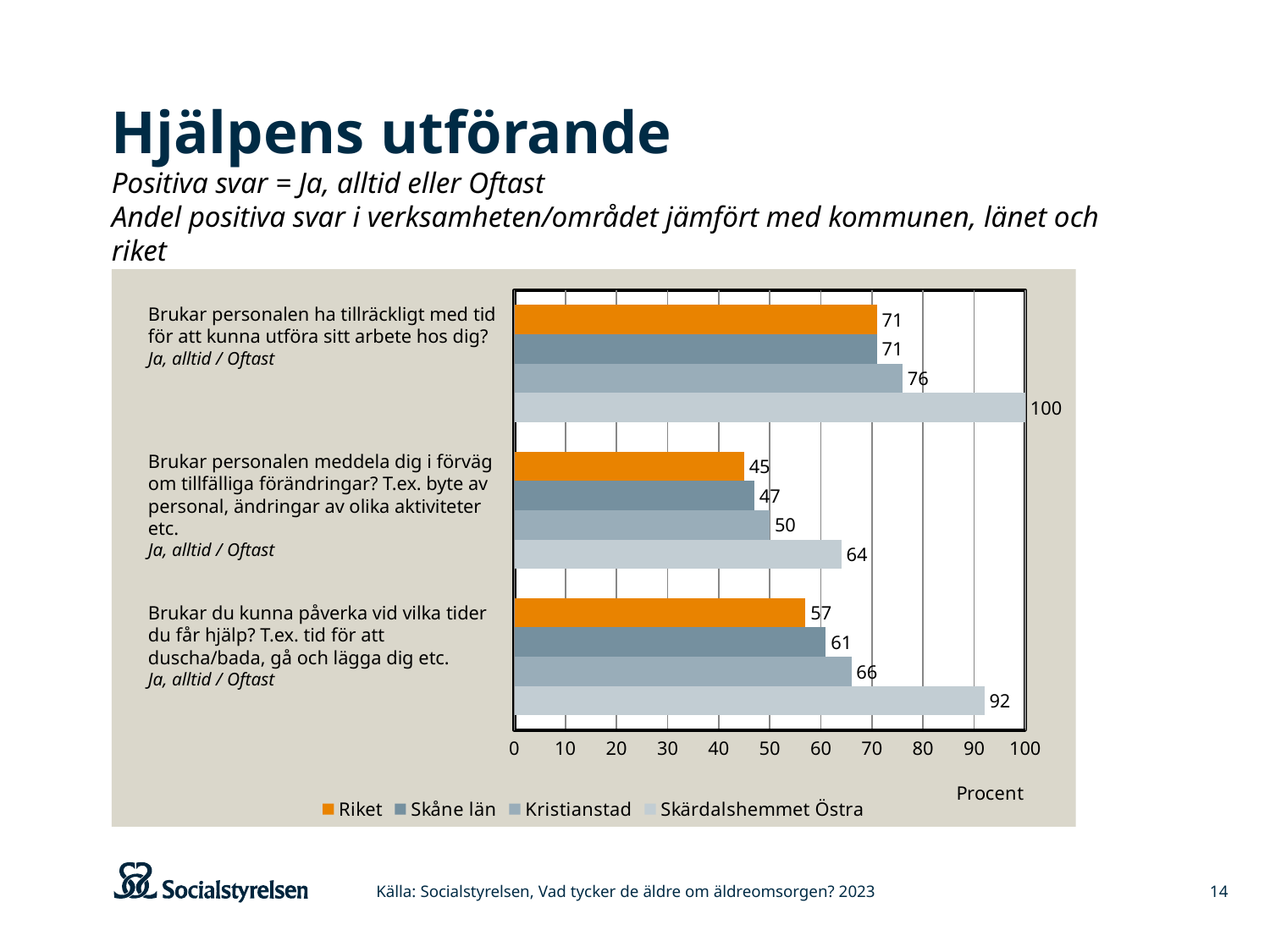
For "Brukar personalen meddela dig i förväg om tillfälliga förändringar?", which is larger: Kristianstad or Skåne län? Kristianstad What kind of chart is shown on the slide? Bar chart Which series has the highest value for "Brukar personalen meddela dig i förväg om tillfälliga förändringar?"? Skärdalshemmet Östra What value does Riket have for "Brukar personalen meddela dig i förväg om tillfälliga förändringar?"? 45 What is the difference between Kristianstad and Skåne län for "Brukar personalen ha tillräckligt med tid för att kunna utföra sitt arbete hos dig?"? 5 How many series does the legend list? 4 How many questions (categories) are shown in the chart? 3 What value does Skärdalshemmet Östra have for "Brukar personalen ha tillräckligt med tid för att kunna utföra sitt arbete hos dig?"? 100 What value does Skåne län have for "Brukar du kunna påverka vid vilka tider du får hjälp?"? 61 Which series has the lowest value for "Brukar du kunna påverka vid vilka tider du får hjälp?"? Riket What value does Kristianstad have for "Brukar du kunna påverka vid vilka tider du får hjälp?"? 66 What is the difference between Skärdalshemmet Östra and Riket for "Brukar du kunna påverka vid vilka tider du får hjälp?"? 35